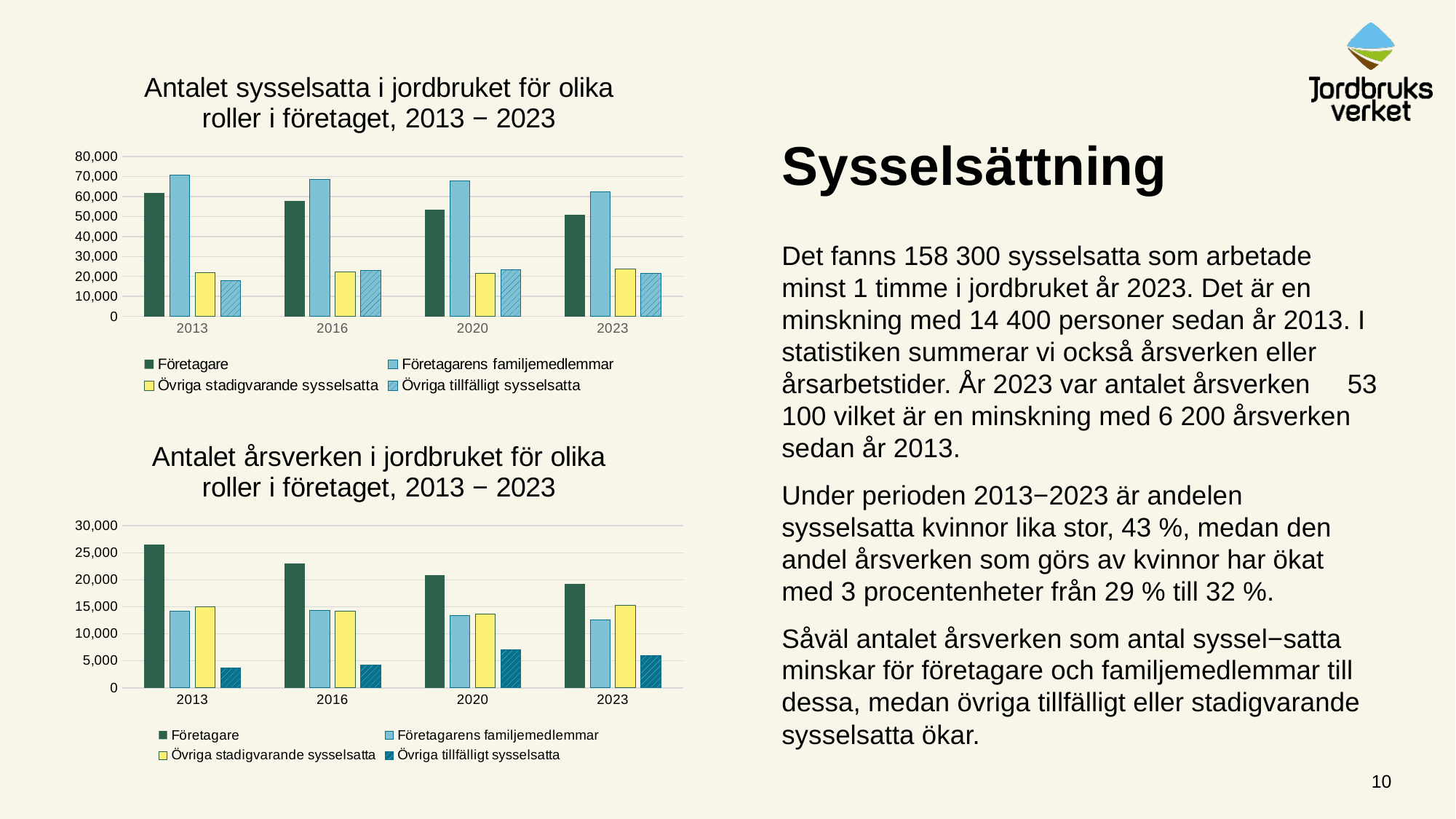
In the top chart (Antalet sysselsatta), is the value for Företagare in 2023 greater or less than 60,000? less In the top chart (Antalet sysselsatta), which series has the highest value in 2013? Företagarens familjemedlemmar In the bottom chart (Antalet årsverken), which series has the highest value in 2023? Företagare In the top chart (Antalet sysselsatta), is the value for Övriga tillfälligt sysselsatta in 2013 greater or less than 20,000? less In the top chart (Antalet sysselsatta), do the values for Företagare rise or fall from 2013 to 2023? Fall In the top chart (Antalet sysselsatta), which is larger for Företagare: the value in 2013 or in 2023? 2013 In the top chart (Antalet sysselsatta), how many series does the legend list? 4 In the top chart (Antalet sysselsatta), how many years are shown on the x axis? 4 In the bottom chart (Antalet årsverken), is the value for Företagare in 2013 greater or less than 25,000? greater What kind of chart is the top chart, 'Antalet sysselsatta i jordbruket för olika roller i företaget, 2013 − 2023'? Bar chart In the bottom chart (Antalet årsverken), which is larger for Övriga tillfälligt sysselsatta: the value in 2013 or in 2020? 2020 In the bottom chart (Antalet årsverken), which series has the lowest value in 2013? Övriga tillfälligt sysselsatta